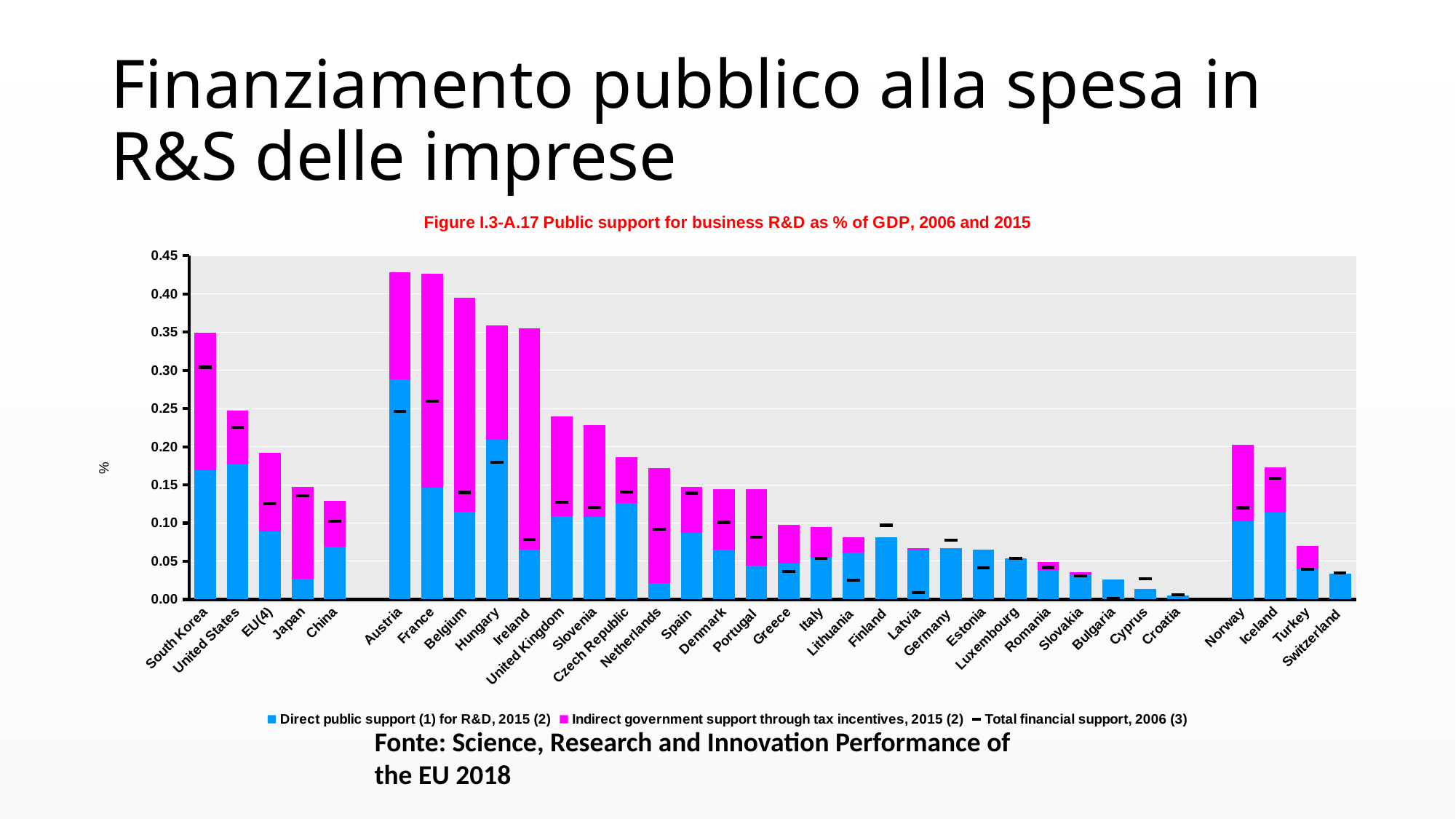
What kind of chart is shown on the slide? stacked bar chart How many countries/categories are shown on the x axis? 34 What is the title of the chart? Figure I.3-A.17 Public support for business R&D as % of GDP, 2006 and 2015 Is the total 2015 bar for Austria greater or less than 0.40? greater Which has the larger total 2015 bar, Norway or Turkey? Norway Is the direct public support (blue) for Japan in 2015 greater or less than 0.05? less Is the total 2015 bar for Switzerland greater or less than 0.05? less Which has the larger direct public support (blue) in 2015, Austria or France? Austria Which country has the lowest total public support for business R&D in 2015? Croatia How many series does the legend list? 3